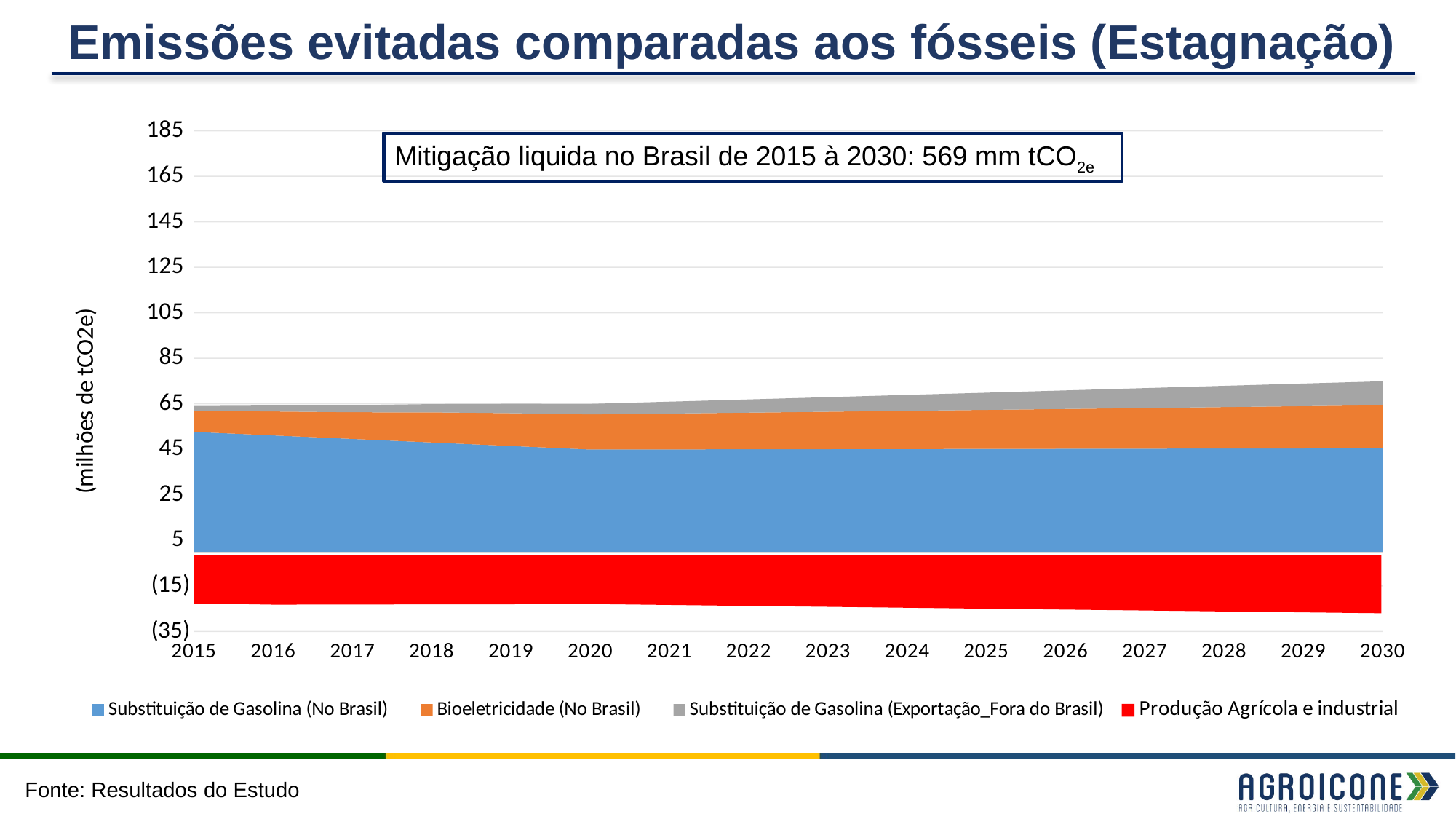
How many series does the legend list? 4 What is the first year shown on the x axis? 2015 What is the title of the chart? Emissões evitadas comparadas aos fósseis (Estagnação) Is the value for Produção Agrícola e industrial in 2030 greater or less than (15)? less Is the top of the stacked positive series in 2030 greater or less than 65? greater Does the Substituição de Gasolina (No Brasil) series rise or fall from 2015 to 2020? fall Does the Substituição de Gasolina (Exportação_Fora do Brasil) series rise or fall from 2015 to 2030? rise How many years are shown along the x axis? 16 According to the text box on the chart, what is the net mitigation in Brazil from 2015 to 2030? 569 mm tCO2e What is the last year shown on the x axis? 2030 What kind of chart is shown on the slide? Stacked area chart Is the value for Substituição de Gasolina (No Brasil) in 2015 greater or less than 45? greater